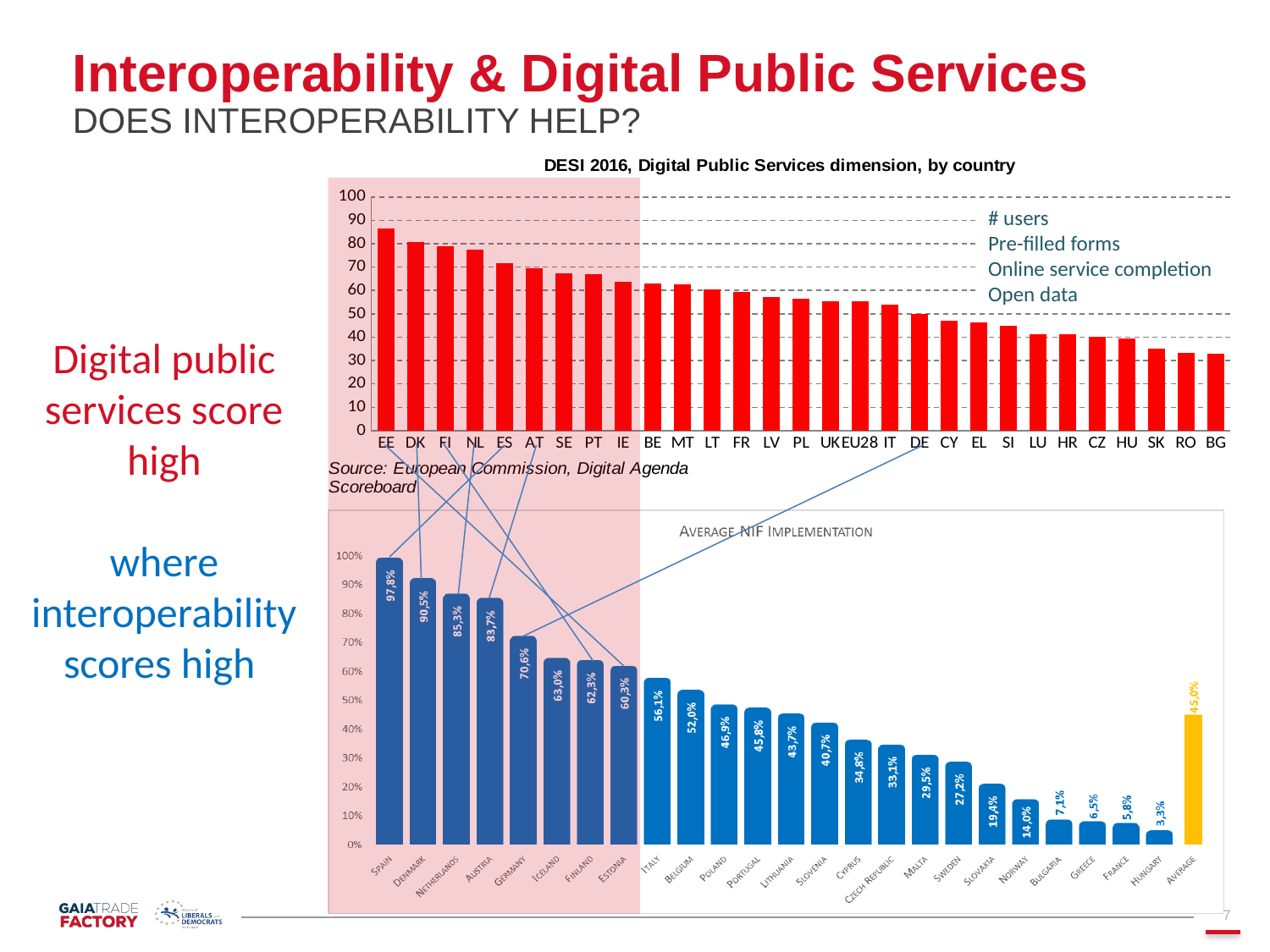
In the Average NIF Implementation chart, which country has the lowest value? Hungary In the DESI 2016 Digital Public Services chart, is the value for EE greater or less than 80? greater In the DESI 2016 Digital Public Services chart, is the value for BG greater or less than 40? less In the DESI 2016 Digital Public Services chart, which country has the highest value? EE In the Average NIF Implementation chart, which is larger, the value for Italy or the value for Belgium? Italy In the DESI 2016 Digital Public Services chart, do the values rise or fall from left to right along the x axis? fall What kind of chart is the DESI 2016 Digital Public Services chart? bar chart In the Average NIF Implementation chart, what is the value shown for Average? 45,0% In the Average NIF Implementation chart, what is the value for Spain? 97,8% In the Average NIF Implementation chart, what is the difference between Denmark and Netherlands? 5,2% In the Average NIF Implementation chart, which country has the highest value? Spain In the Average NIF Implementation chart, what is the value for Hungary? 3,3%